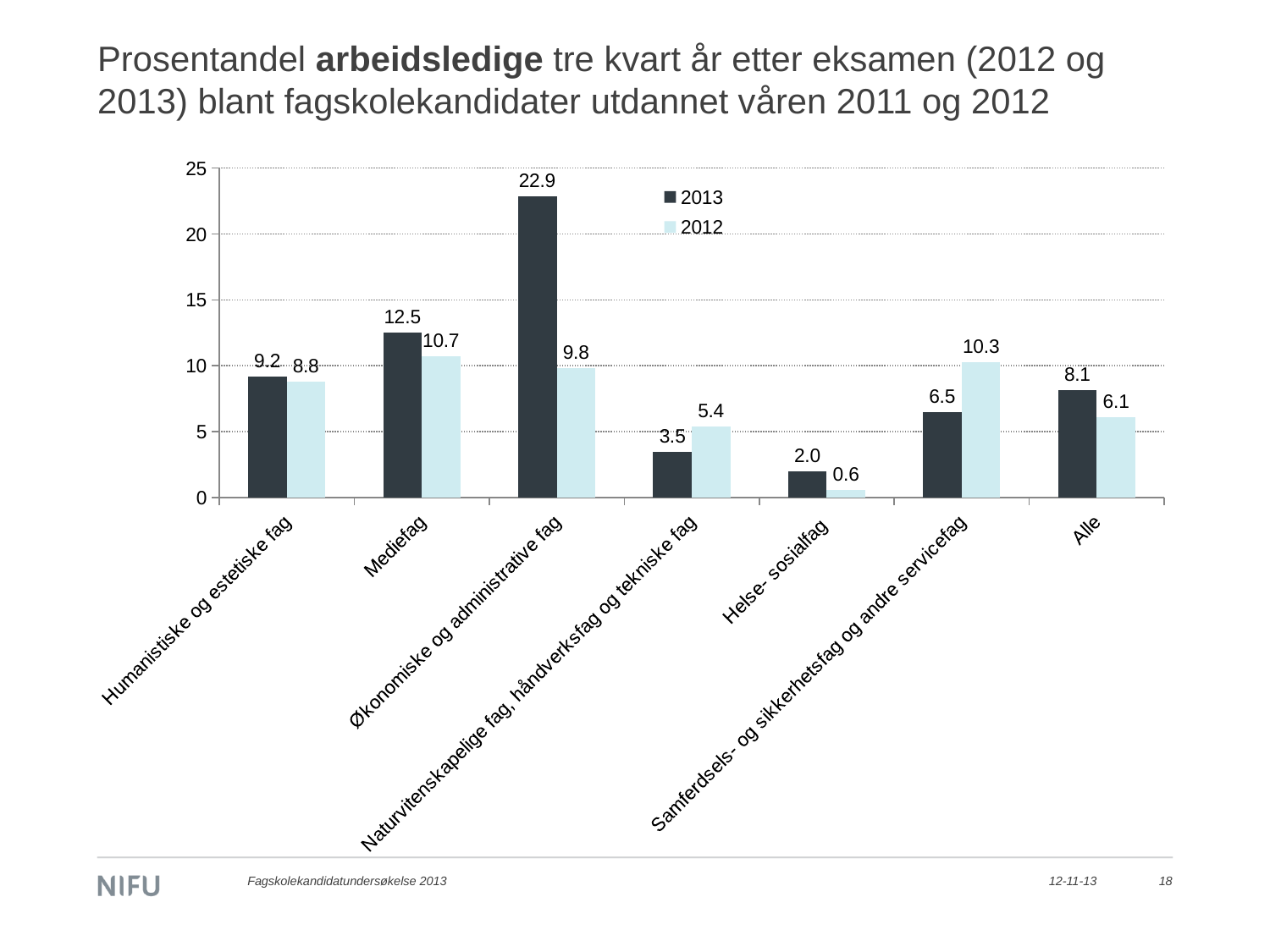
Which series is shown with the dark bars? 2013 What kind of chart is shown on the slide? Bar chart How many categories are shown on the x axis? 7 How many series does the legend list? 2 Which is larger for Naturvitenskapelige fag, håndverksfag og tekniske fag: the 2013 value or the 2012 value? 2012 What is the 2012 value for Samferdsels- og sikkerhetsfag og andre servicefag? 10.3 Which category has the lowest 2012 value? Helse- sosialfag Which category has the highest 2013 value? Økonomiske og administrative fag What is the 2013 value for Alle? 8.1 What is the difference between the 2013 and 2012 values for Økonomiske og administrative fag? 13.1 What is the 2013 value for Økonomiske og administrative fag? 22.9 Is the 2013 value for Mediefag greater or less than 10? greater